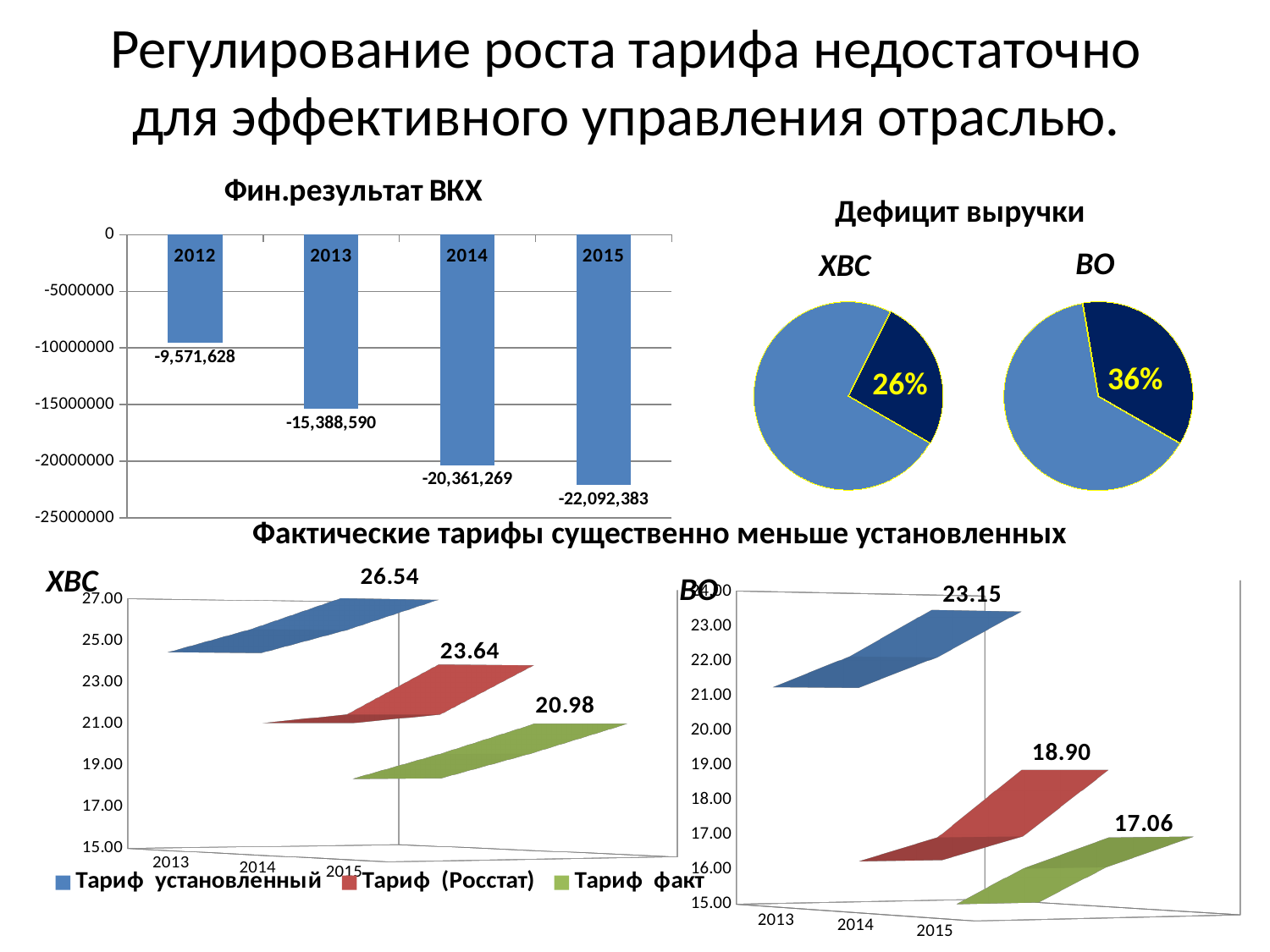
In the 'Фин.результат ВКХ' chart, what is the value for 2015? -22,092,383 In the 'Фин.результат ВКХ' chart, what is the value for 2012? -9,571,628 In the 'Фин.результат ВКХ' chart, which year has the lowest (most negative) value? 2015 In the 'Фин.результат ВКХ' chart, do the values rise or fall from 2012 to 2015? fall How many series does the legend of the bottom tariff charts list? 3 In the 'Дефицит выручки' pie chart for ХВС, what share is shown for the dark slice? 26% What kind of chart is 'Фин.результат ВКХ'? bar chart In the 'Фин.результат ВКХ' chart, how many years are shown? 4 In the bottom-left ХВС tariff chart, what is the labelled value for 'Тариф установленный' in 2015? 26.54 In the 'Дефицит выручки' pie chart for ВО, what share is shown for the dark slice? 36% In the 'Дефицит выручки' pie charts, which has the larger dark slice, ХВС or ВО? ВО In the 'Фин.результат ВКХ' chart, what is the difference between the 2014 and 2013 values? 4,972,679